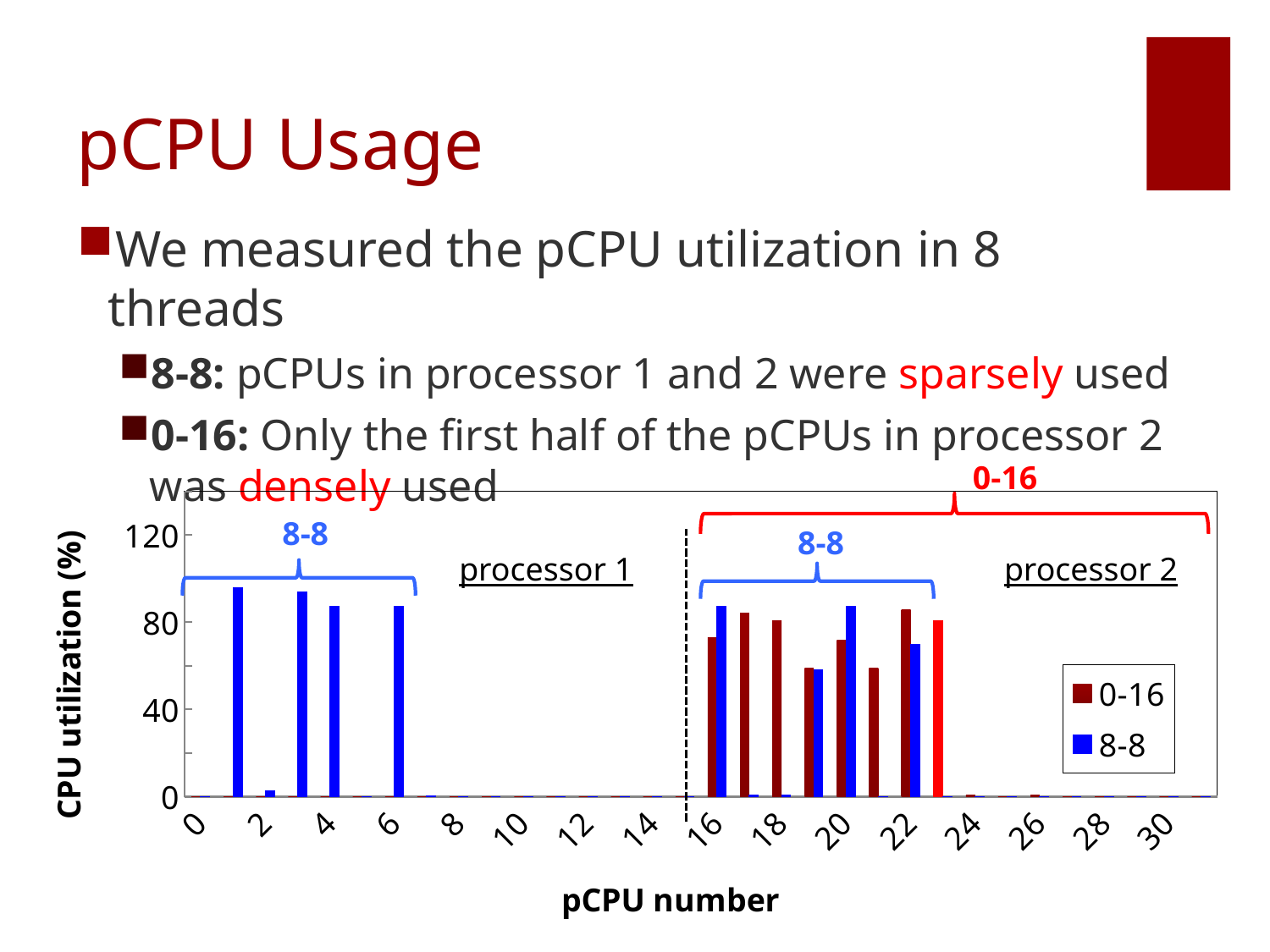
Is the 0-16 value at pCPU 19 greater or less than 80? less Is the 8-8 value at pCPU 22 greater or less than 80? less At pCPU 22, which series has the larger value, 0-16 or 8-8? 0-16 At pCPU 16, which series has the larger value, 0-16 or 8-8? 8-8 What is the title of the y axis? CPU utilization (%) Is the 0-16 value at pCPU 21 greater or less than 80? less What kind of chart is shown on the slide? bar chart At pCPU 20, which series has the larger value, 0-16 or 8-8? 8-8 What are the two series named in the legend? 0-16 and 8-8 How many series does the legend list? 2